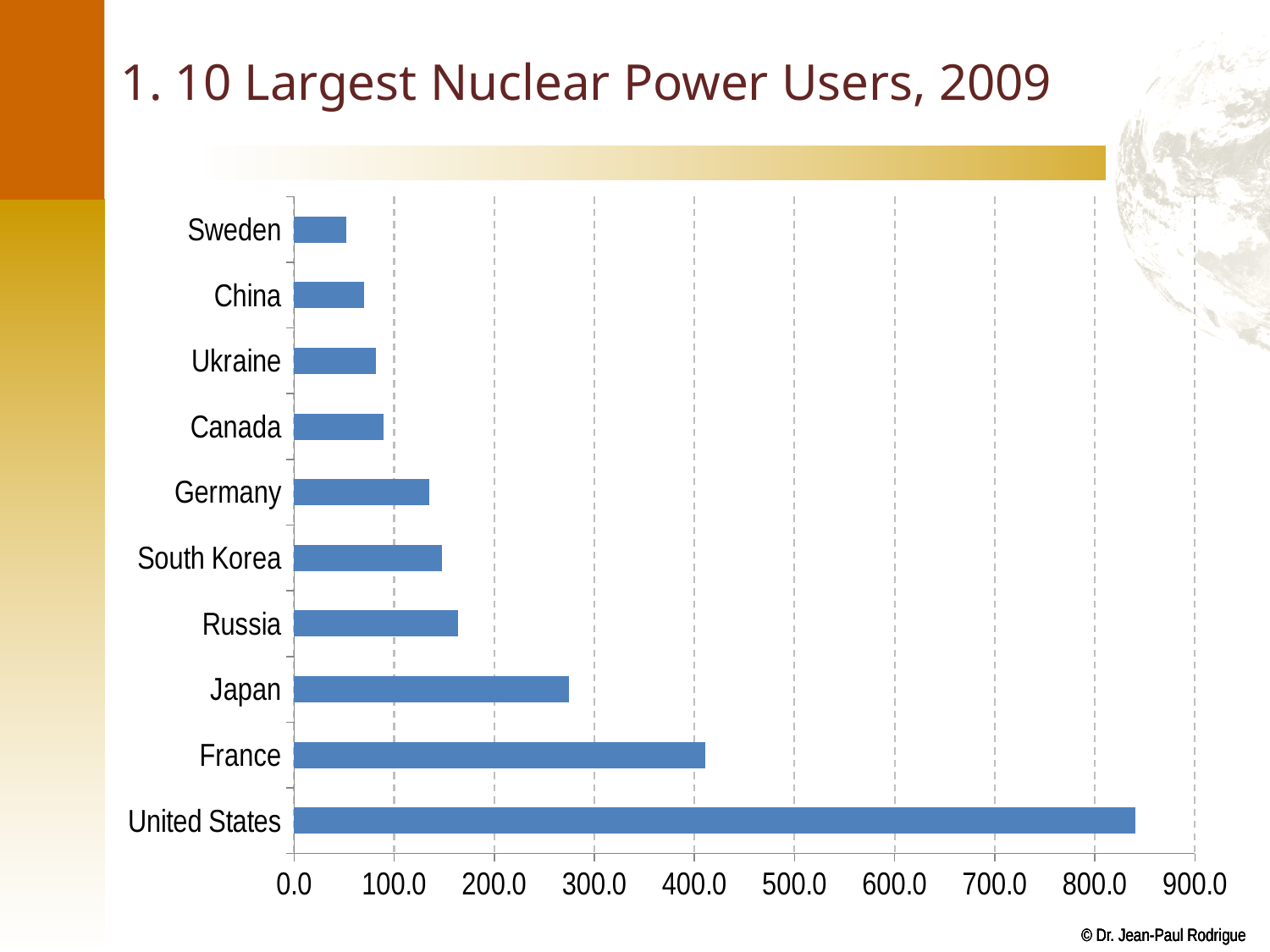
Which country has the lowest value in the chart? Sweden Which has a larger value, France or Japan? France Is the value for Sweden greater or less than 100.0? less Is the value for Germany greater or less than 100.0? greater Is the value for Japan greater or less than 300.0? less Which has a larger value, Russia or Canada? Russia What is the title of the slide containing the chart? 1. 10 Largest Nuclear Power Users, 2009 How many countries are shown in the chart? 10 Which country has the highest value in the chart? United States What kind of chart is shown on the slide? bar chart